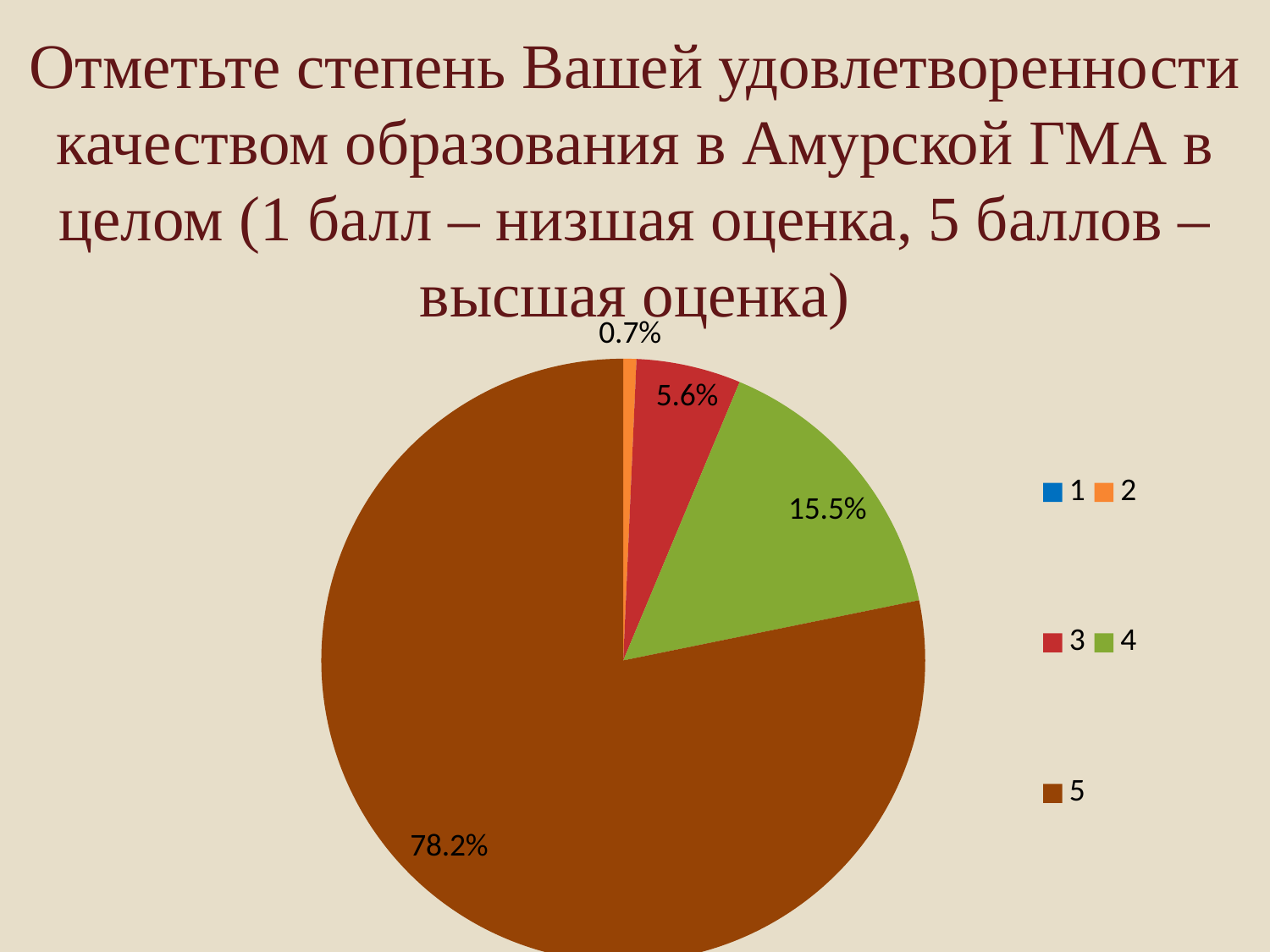
What is the difference between the shares of category 4 and category 3? 9.9% Which category has the largest slice of the pie? 5 Which is larger, the share of category 3 or the share of category 4? 4 What is the difference between the shares of category 5 and category 4? 62.7% What share of the pie does category 2 have? 0.7% What share of the pie does category 5 have? 78.2% Which of the labelled slices is the smallest? 2 What share of the pie does category 4 have? 15.5% What colour is the slice for category 5? brown What kind of chart is shown on the slide? pie chart What share of the pie does category 3 have? 5.6% How many entries does the legend list? 5